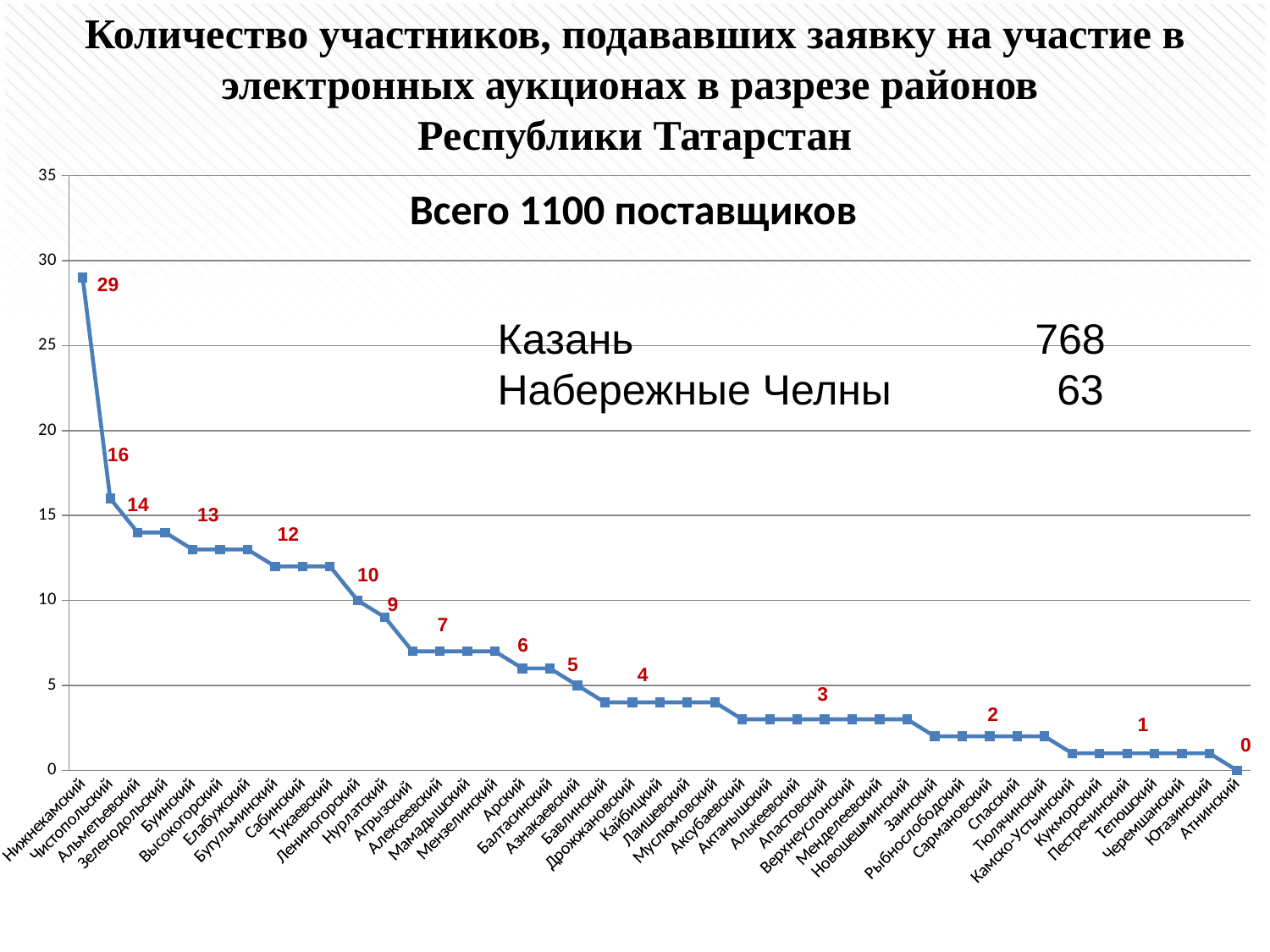
Which is larger, the value for Чистопольский or the value for Нурлатский? Чистопольский Do the values rise or fall from left to right along the x axis? fall Is the value for Зеленодольский greater or less than 10? greater What kind of chart is shown on the slide? line chart What is the value for Чистопольский? 16 Which district has the highest value? Нижнекамский Which district has the lowest value? Атнинский What is the value for Нижнекамский? 29 What is the value for Атнинский? 0 What is the value for Лениногорский? 10 According to the text on the chart, how many suppliers are there in total (Всего)? 1100 поставщиков What is the difference between the values for Нижнекамский and Чистопольский? 13